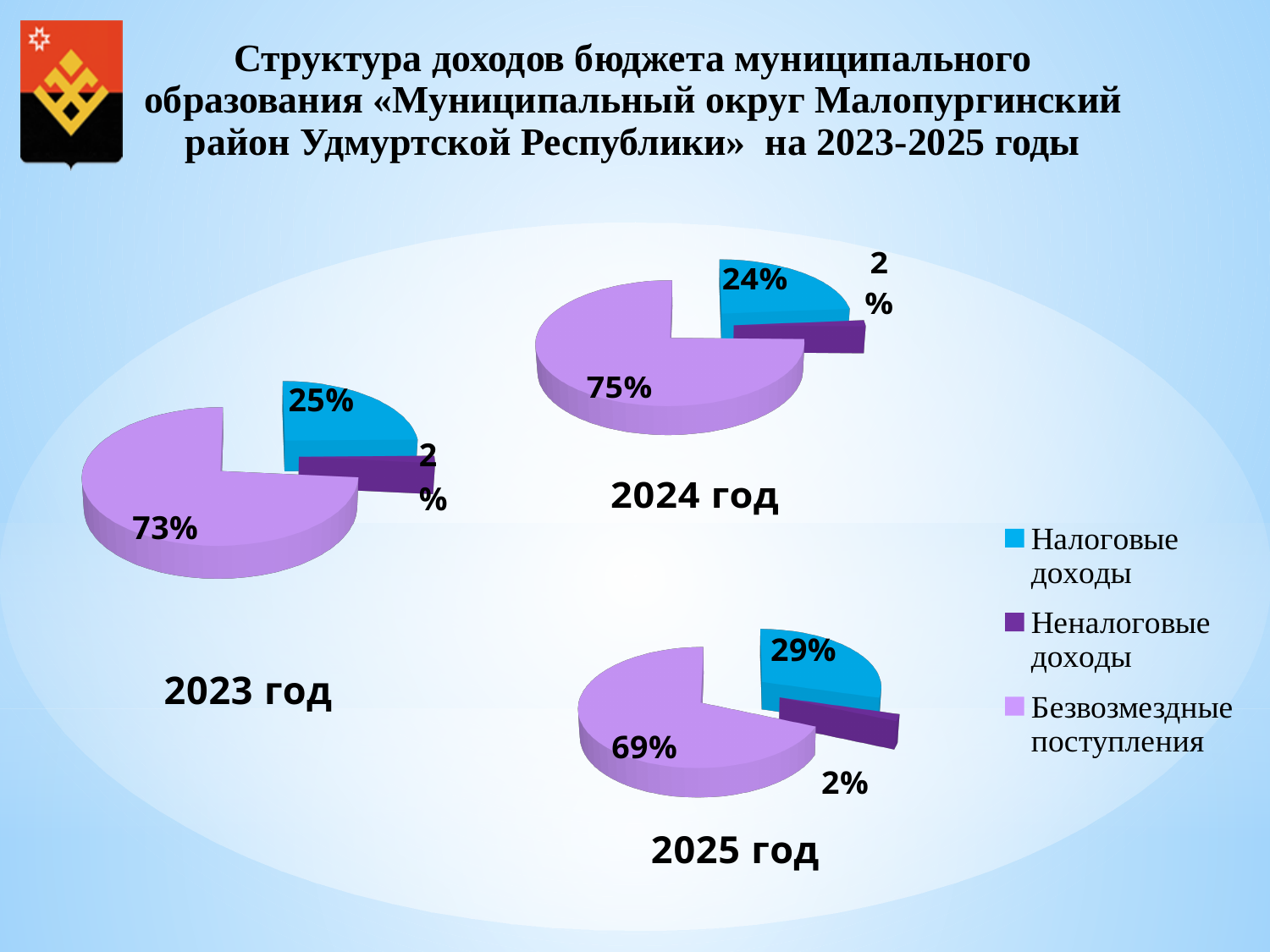
In the 2024 год pie chart, what share is Налоговые доходы? 24% In the 2025 год pie chart, what share is Неналоговые доходы? 2% In the 2023 год pie chart, what share is Безвозмездные поступления? 73% In the 2025 год pie chart, what is the difference between the Безвозмездные поступления share and the Налоговые доходы share? 40% Which colour represents Неналоговые доходы in the legend? Purple How many slices does the 2023 год pie chart have? 3 How many entries does the legend list? 3 In the 2024 год pie chart, which category has the smallest slice? Неналоговые доходы In the 2025 год pie chart, what share is Безвозмездные поступления? 69% In the 2023 год pie chart, which category has the largest slice? Безвозмездные поступления What kind of chart is the 2024 год chart? Pie chart Which is larger: the Налоговые доходы share in the 2025 год chart or in the 2024 год chart? 2025 год